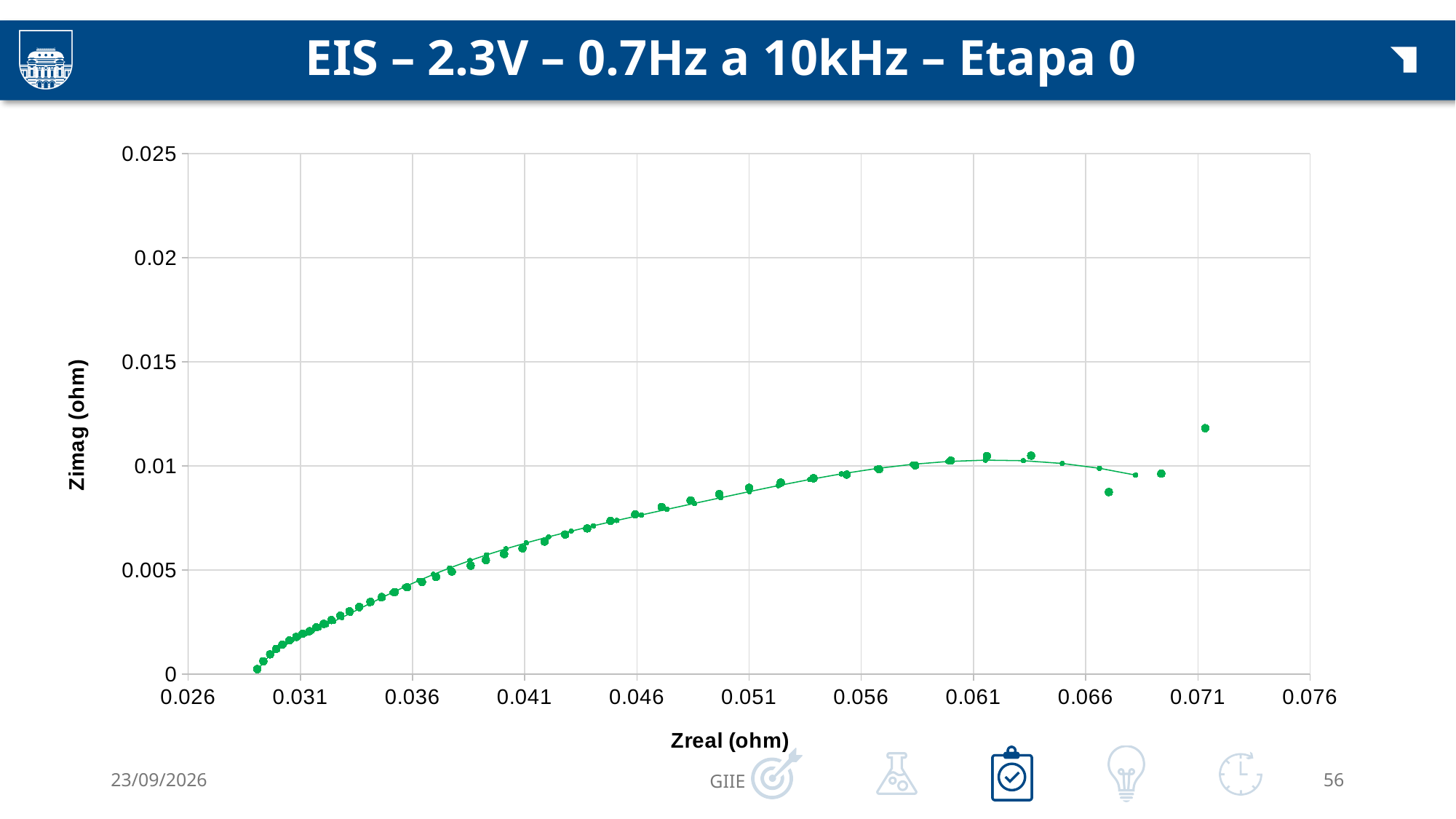
What is the title of the chart on the slide? EIS – 2.3V – 0.7Hz a 10kHz – Etapa 0 Is the Zimag value of the point at Zreal 0.051 greater or less than 0.01? less Is the Zimag value of the leftmost point (near Zreal 0.029) greater or less than 0.005? less Do the Zimag values rise or fall as Zreal increases from 0.026 to 0.061? rise Is the Zimag value of the rightmost point (near Zreal 0.071) greater or less than 0.01? greater What kind of chart is shown on the slide? scatter chart Which has the larger Zimag value: the point at Zreal 0.036 or the point at Zreal 0.056? the point at Zreal 0.056 What is the label of the vertical axis of the chart? Zimag (ohm) Which has the larger Zimag value: the leftmost point or the rightmost point on the chart? the rightmost point